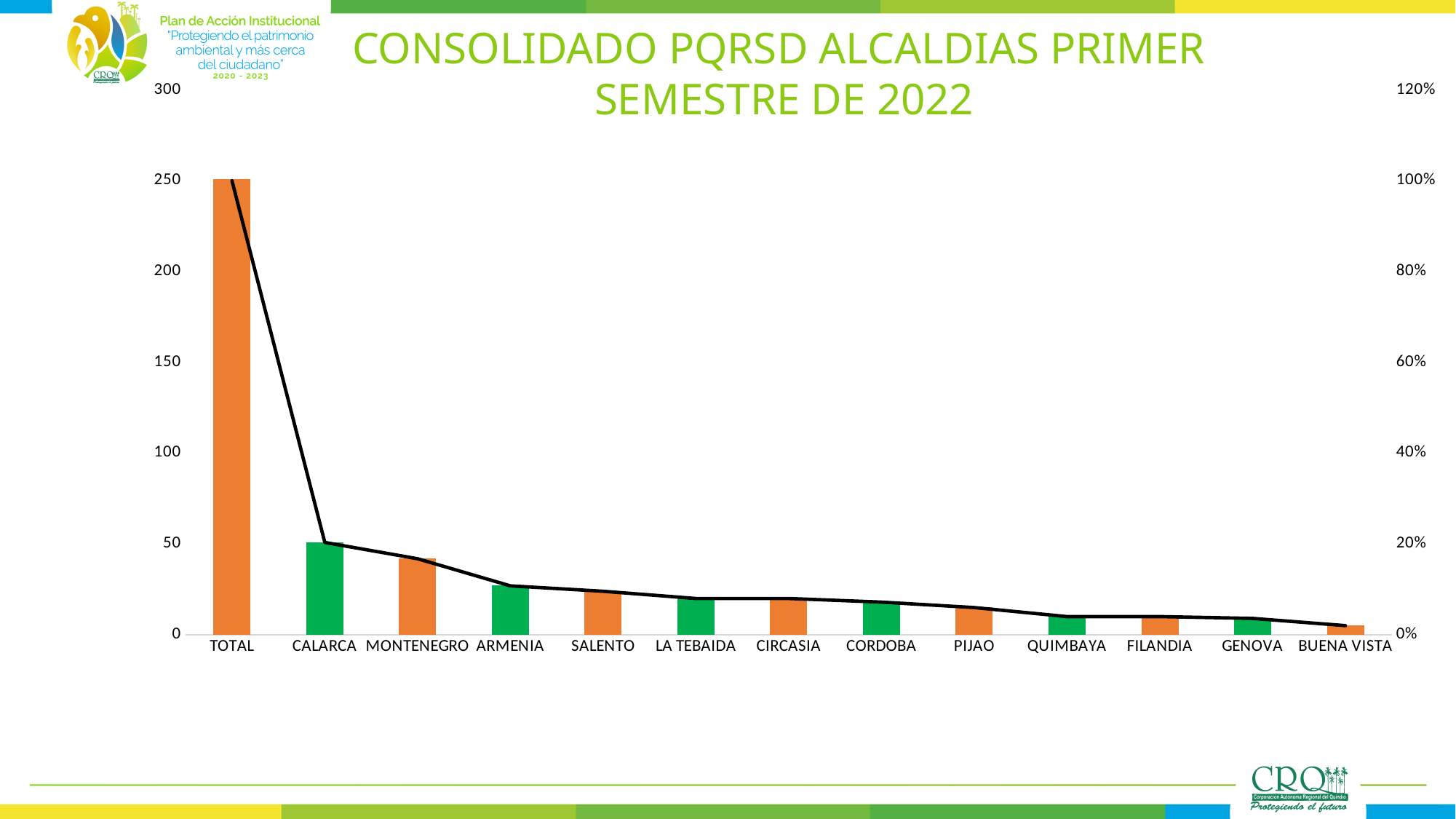
Is the value for MONTENEGRO greater or less than 50? less Do the bar values rise or fall moving from left to right along the x axis? fall Which category has the shortest bar in the chart? BUENA VISTA How many categories are shown on the x axis of the chart? 13 Which category has the tallest bar in the chart? TOTAL Which bar is taller, MONTENEGRO or ARMENIA? MONTENEGRO Is the value for ARMENIA greater or less than 50? less What percentage does the line reach for TOTAL on the right-hand axis? 100% What kind of chart is shown on the slide? combination bar and line chart